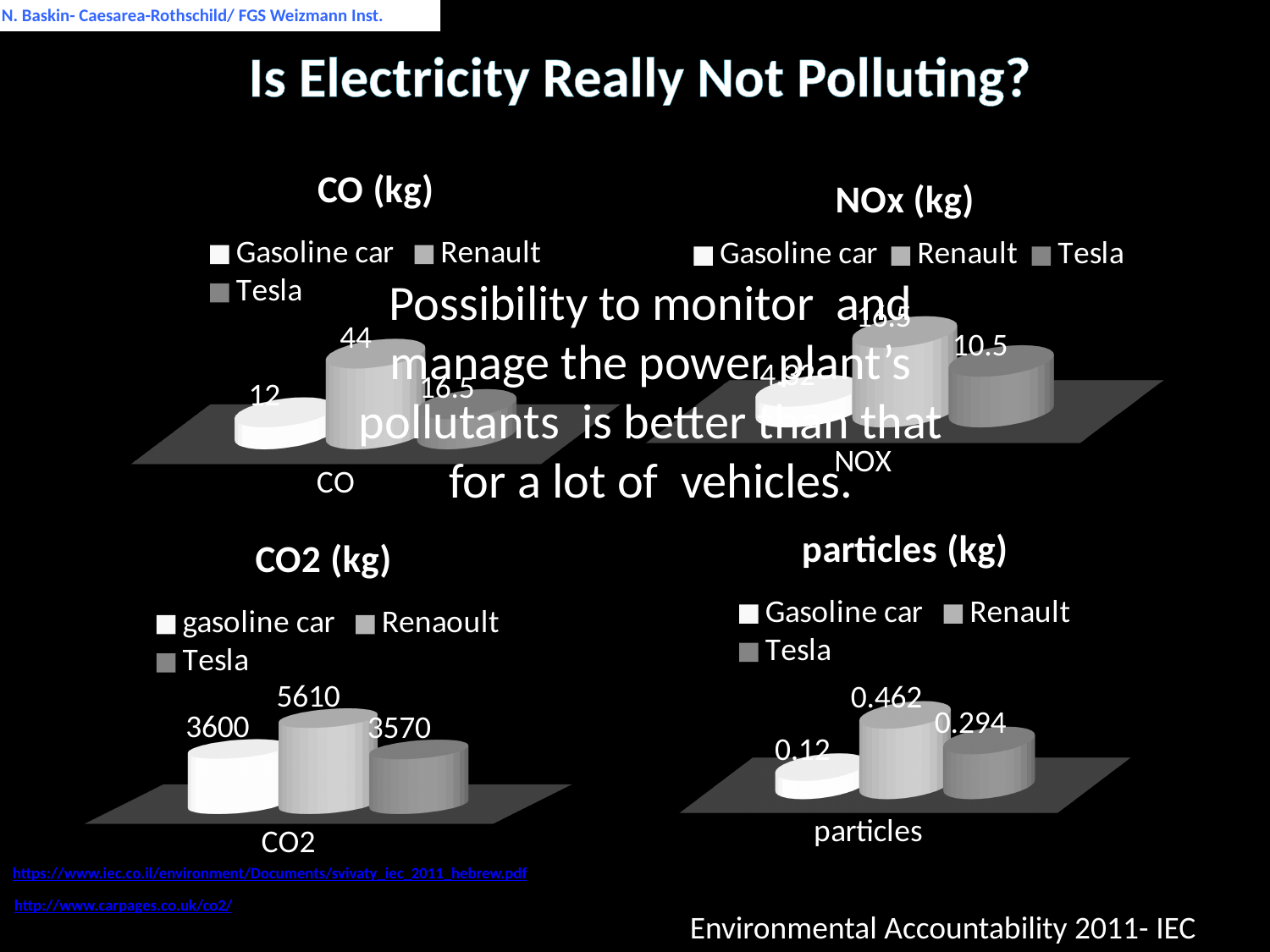
In the particles (kg) chart, what is the value for Tesla? 0.294 In the CO (kg) chart, what is the value for the Gasoline car? 12 In the NOx (kg) chart, what is the value for Tesla? 10.5 In the CO2 (kg) chart, what is the value for Renaoult? 5610 In the particles (kg) chart, which is larger, the Gasoline car value or the Renault value? Renault In the CO (kg) chart, which series has the highest value? Renault What kind of chart is the CO2 (kg) chart? Bar chart In the CO (kg) chart, what is the difference between the Renault value and the Tesla value? 27.5 In the CO (kg) chart, what is the value for Renault? 44 In the CO2 (kg) chart, which series has the lowest value? Tesla How many series does the legend of the particles (kg) chart list? 3 In the CO2 (kg) chart, what is the difference between the Renaoult value and the gasoline car value? 2010